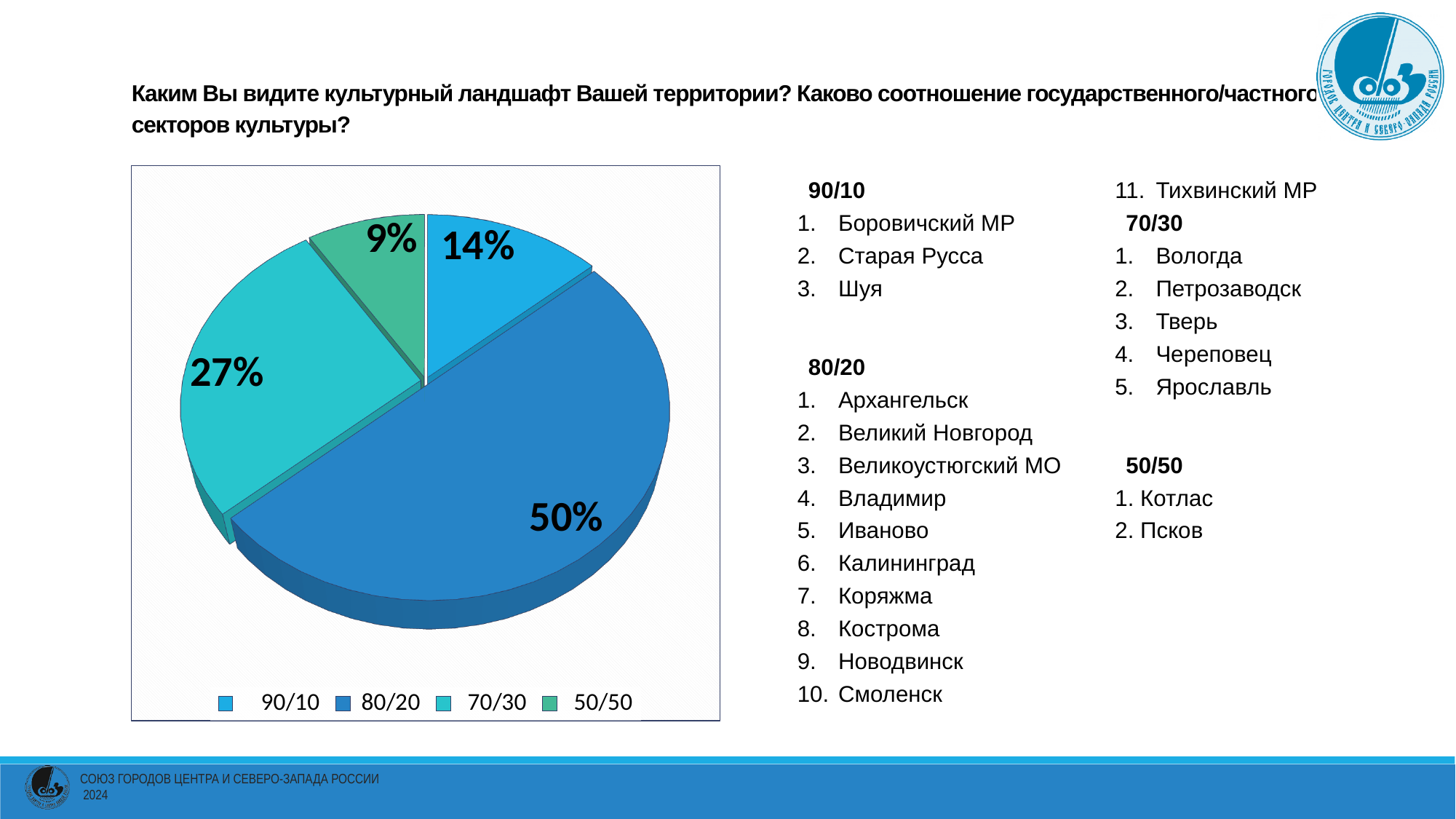
How many entries does the chart legend list? 4 What share of the pie does the 80/20 slice represent? 50% Which slice is larger, 90/10 or 70/30? 70/30 What kind of chart is shown on the slide? pie chart What share of the pie does the 70/30 slice represent? 27% What is the difference in percentage points between the 80/20 slice and the 70/30 slice? 23 What is the difference in percentage points between the 90/10 slice and the 50/50 slice? 5 Which category has the largest slice of the pie? 80/20 What share of the pie does the 50/50 slice represent? 9% How many slices does the pie chart have? 4 Which category has the smallest slice of the pie? 50/50